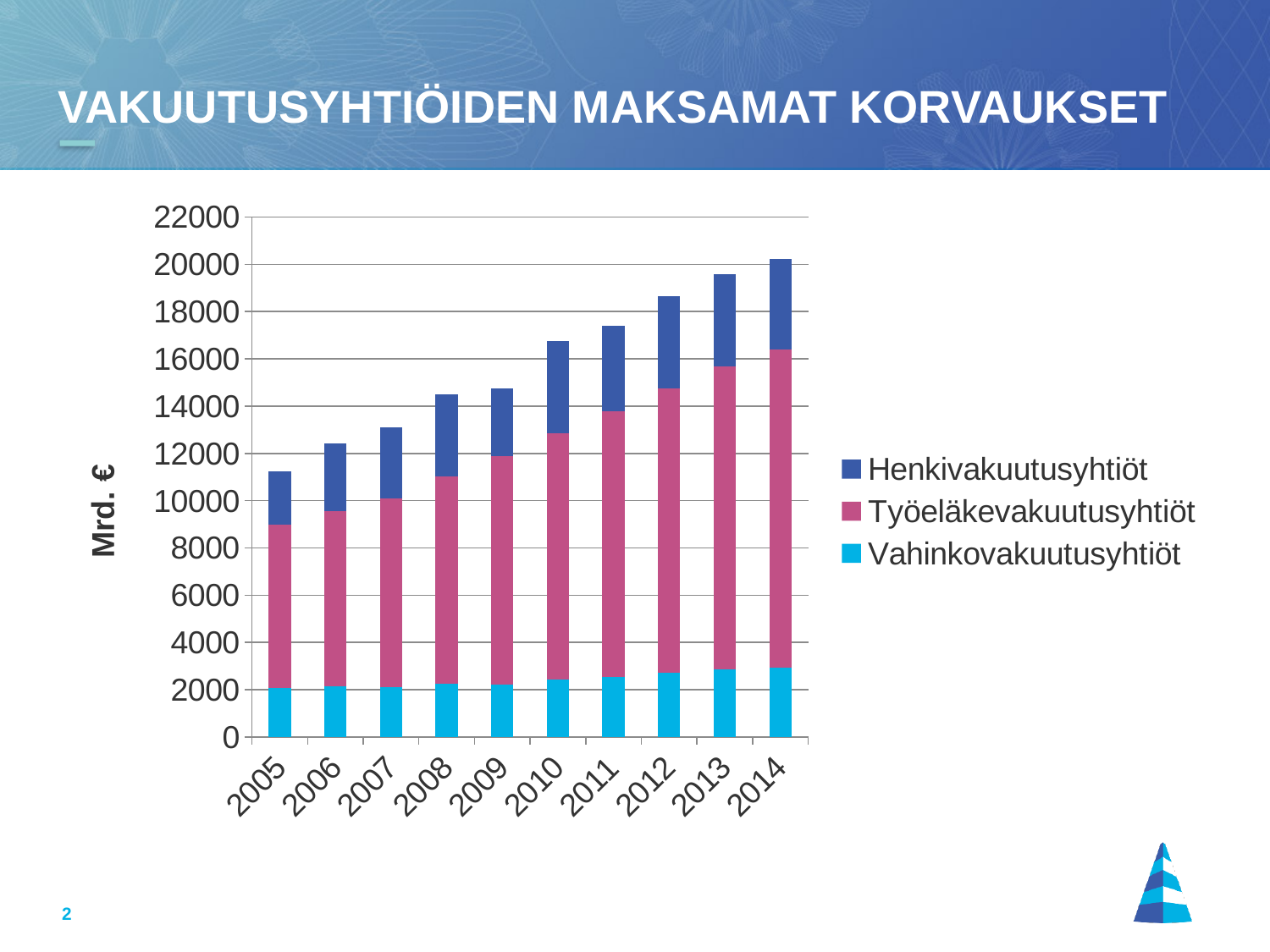
Is the Vahinkovakuutusyhtiöt segment for 2014 greater or less than 4000? less Which is larger, the total bar for 2014 or the total bar for 2005? 2014 Is the total bar for 2005 greater or less than 10000? greater Is the total bar for 2012 greater or less than 18000? greater Do the total bar heights rise or fall from 2005 to 2014? rise How many series does the chart's legend list? 3 What kind of chart is shown on the slide? stacked bar chart Which year has the lowest total bar? 2005 What is the label on the chart's vertical axis? Mrd. € Which year has the highest total bar? 2014 How many years are shown on the x axis of the chart? 10